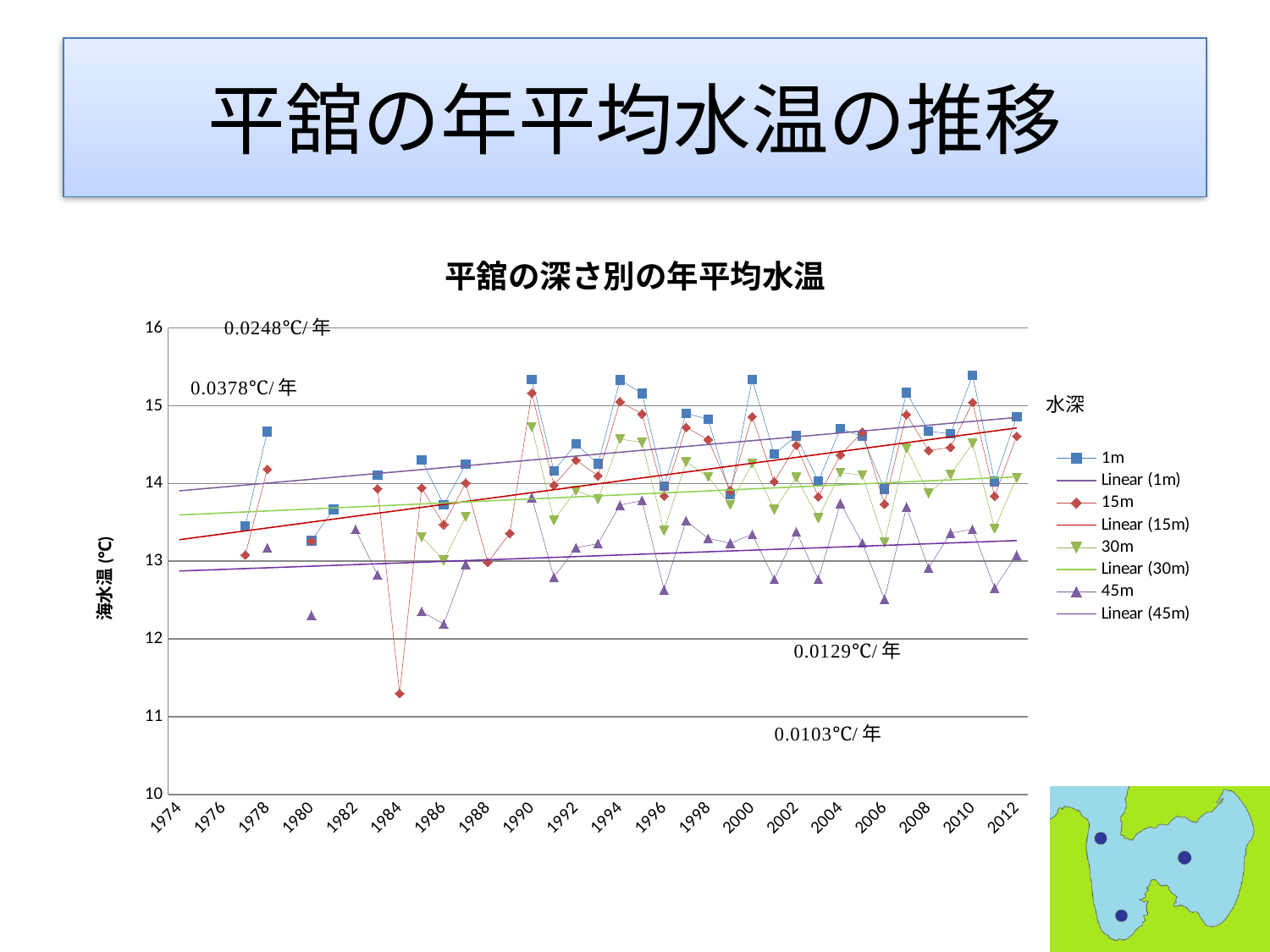
Is the value for the 15m series in 1984 greater or less than 12? less What is the title of the chart? 平舘の深さ別の年平均水温 Is the value for the 1m series in 1990 greater or less than 15? greater Is the value for the 1m series in 2010 greater or less than 15? greater What is the label of the vertical axis? 海水温 (℃) In 1990, which series has the higher value, 1m or 45m? 1m Do the linear trend lines rise or fall from 1974 to 2012? Rise How many series does the chart legend list? 8 What kind of chart is shown on the slide? Line chart Which depth series generally has the lowest water temperatures across the chart? 45m